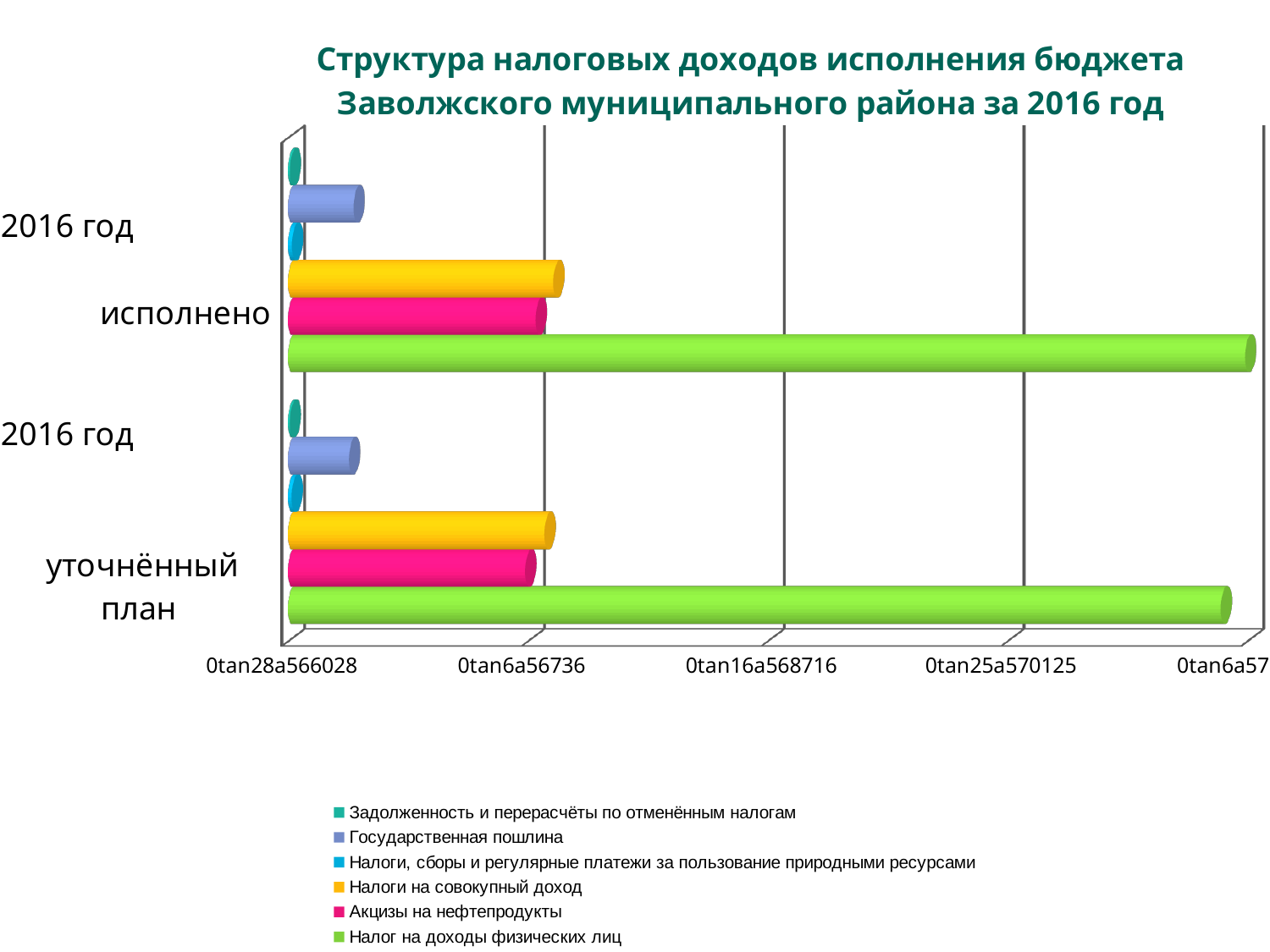
How many categories are shown on the vertical axis? 2 For "2016 год исполнено", which is larger: Государственная пошлина or Налоги на совокупный доход? Налоги на совокупный доход What is the title of the chart? Структура налоговых доходов исполнения бюджета Заволжского муниципального района за 2016 год What kind of chart is shown on the slide? bar chart Which series is shown in green in the legend? Налог на доходы физических лиц Which series has the longest bar for the category "2016 год исполнено"? Налог на доходы физических лиц For "2016 год исполнено", which is larger: Налог на доходы физических лиц or Акцизы на нефтепродукты? Налог на доходы физических лиц For "2016 год уточнённый план", which is larger: Акцизы на нефтепродукты or Государственная пошлина? Акцизы на нефтепродукты Which series has the longest bar for the category "2016 год уточнённый план"? Налог на доходы физических лиц How many series does the legend list? 6